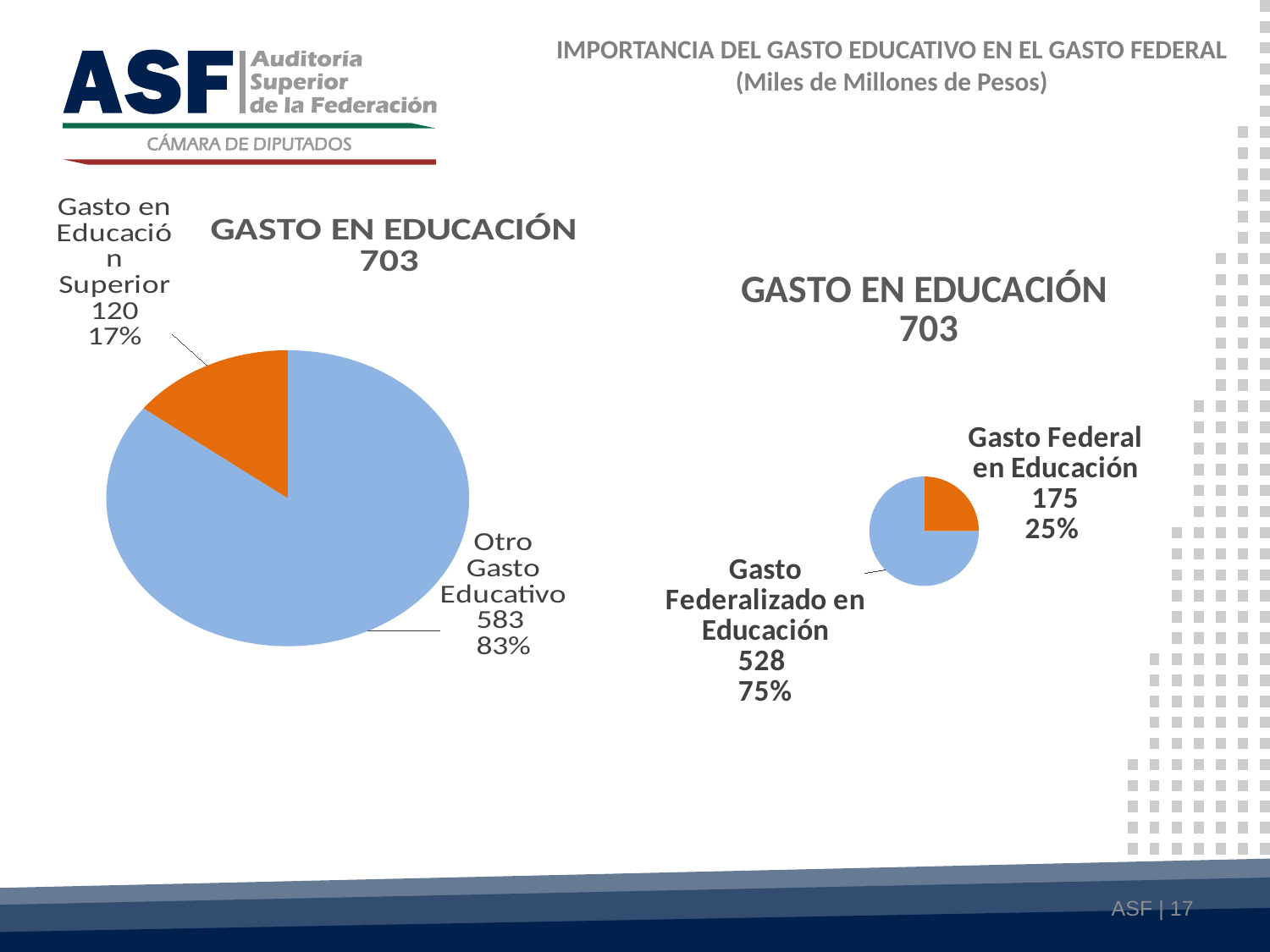
In the left pie chart, what share of the pie is Gasto en Educación Superior? 17% In the left pie chart, what is the value for Otro Gasto Educativo? 583 In the right pie chart, what is the value for Gasto Federalizado en Educación? 528 In the right pie chart, which slice is the largest? Gasto Federalizado en Educación In the left pie chart, what share of the pie is Otro Gasto Educativo? 83% In the left pie chart, what is the difference between Otro Gasto Educativo and Gasto en Educación Superior? 463 In the left pie chart, what is the value for Gasto en Educación Superior? 120 In the left pie chart, which slice is the smallest? Gasto en Educación Superior In the right pie chart, what share of the pie is Gasto Federalizado en Educación? 75% How many slices does the right pie chart have? 2 In the right pie chart, what is the value for Gasto Federal en Educación? 175 What kind of chart is shown on the right side of the slide? Pie chart